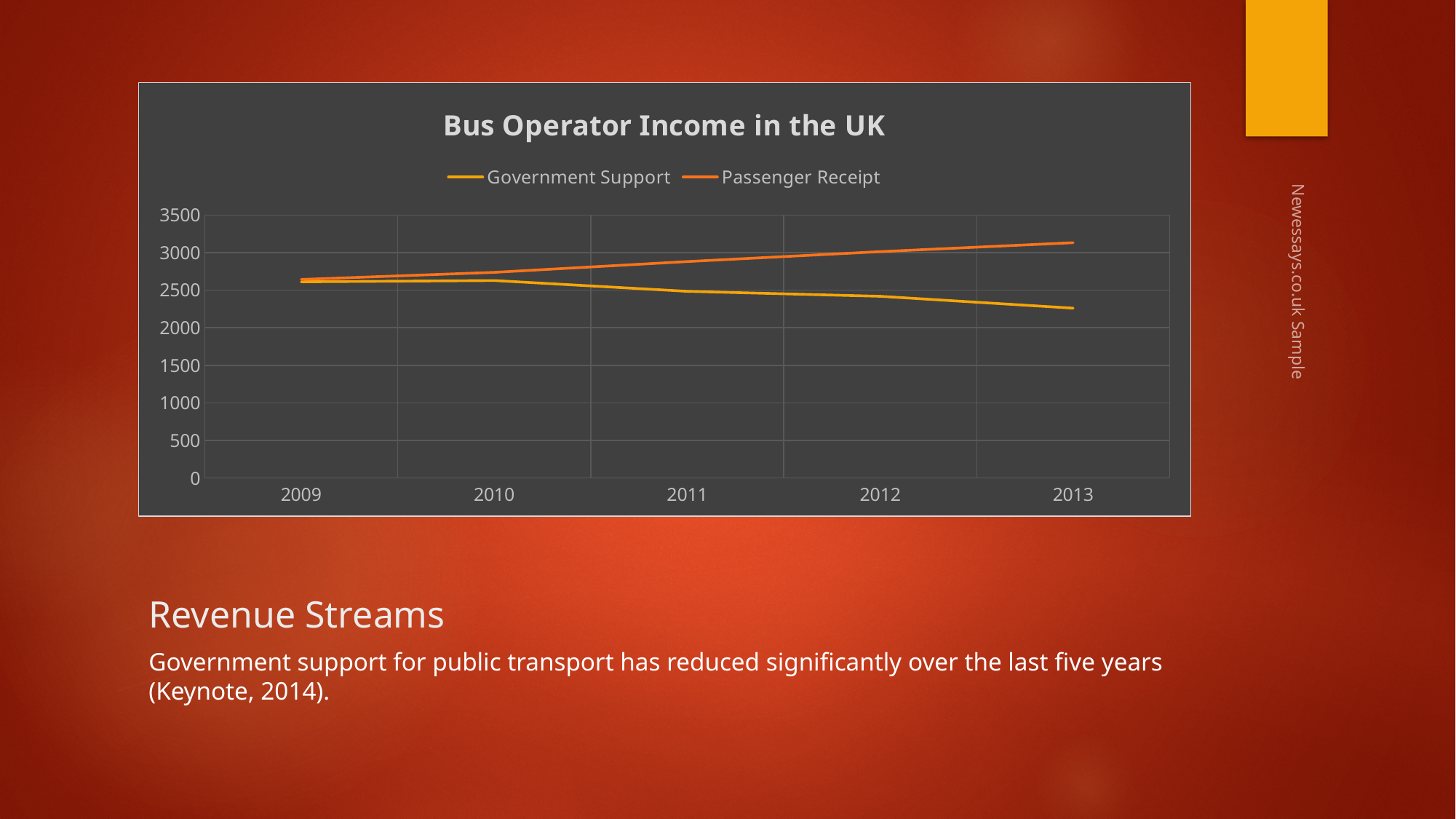
Is the Passenger Receipt value for 2013 greater or less than 3000? greater How many years are plotted along the x axis? 5 Is the Passenger Receipt value for 2011 greater or less than 3000? less Does the Passenger Receipt line rise or fall from 2009 to 2013? Rise Does the Government Support line rise or fall from 2009 to 2013? Fall In 2013, which series has the larger value, Government Support or Passenger Receipt? Passenger Receipt In which year is Government Support at its lowest? 2013 What is the title of the chart? Bus Operator Income in the UK How many series does the chart's legend list? 2 In which year is Passenger Receipt at its highest? 2013 What type of chart is shown on the slide? Line chart Is the Government Support value for 2013 greater or less than 2500? less